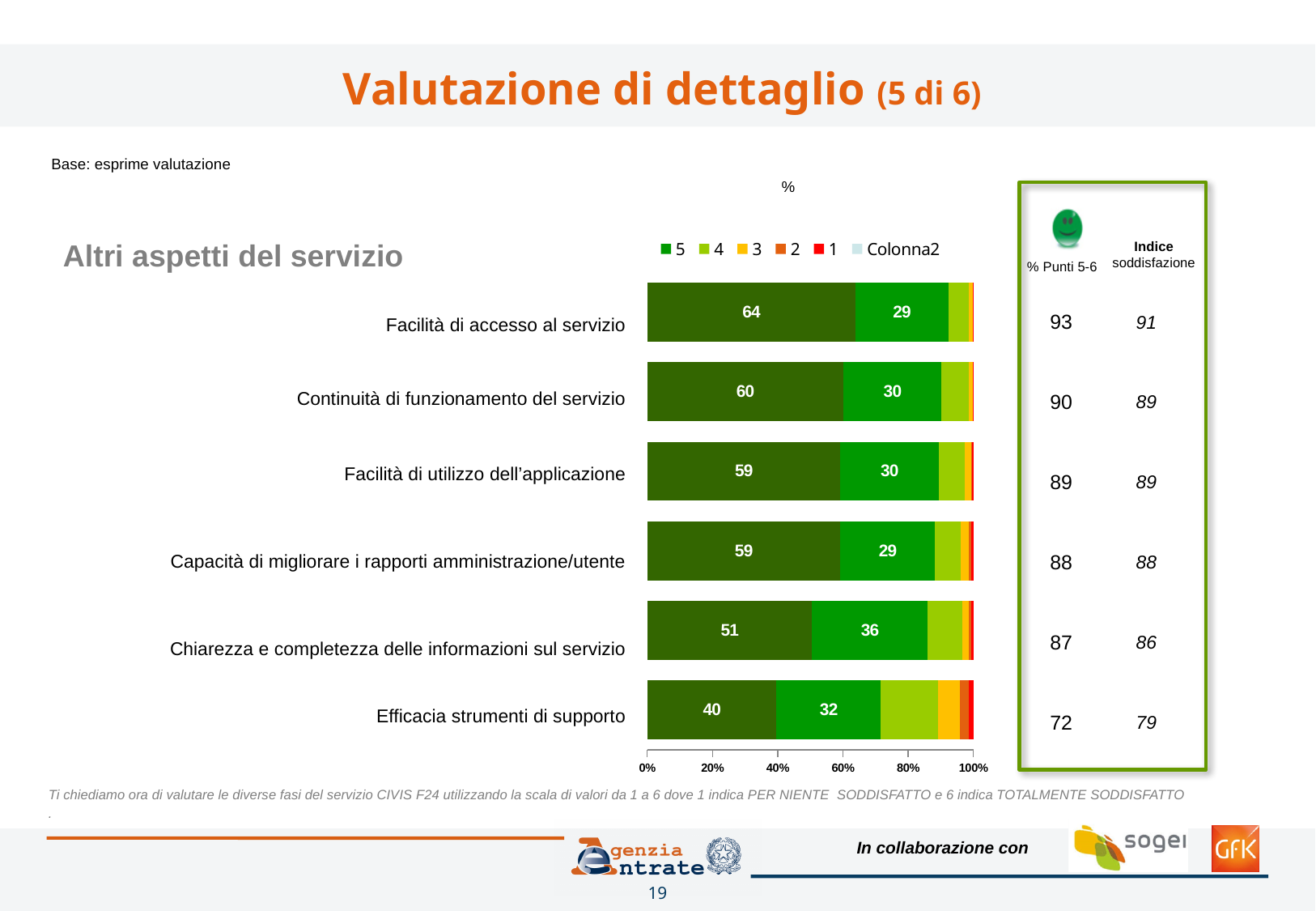
What is the difference between the series 5 values for "Facilità di accesso al servizio" and "Efficacia strumenti di supporto"? 24 Which category has the lowest value for series 5? Efficacia strumenti di supporto What is the value of series 5 for "Facilità di accesso al servizio"? 64 How many series does the legend list? 6 What is the combined value of series 5 and series 4 for "Facilità di accesso al servizio"? 93 How many categories are shown in the chart? 6 What kind of chart is shown on the slide? Stacked bar chart What is the title shown to the left of the chart? Altri aspetti del servizio Which has the larger series 4 value: "Chiarezza e completezza delle informazioni sul servizio" or "Continuità di funzionamento del servizio"? Chiarezza e completezza delle informazioni sul servizio Which category has the highest value for series 5? Facilità di accesso al servizio What is the value of series 4 for "Efficacia strumenti di supporto"? 32 What is the value of series 5 for "Chiarezza e completezza delle informazioni sul servizio"? 51